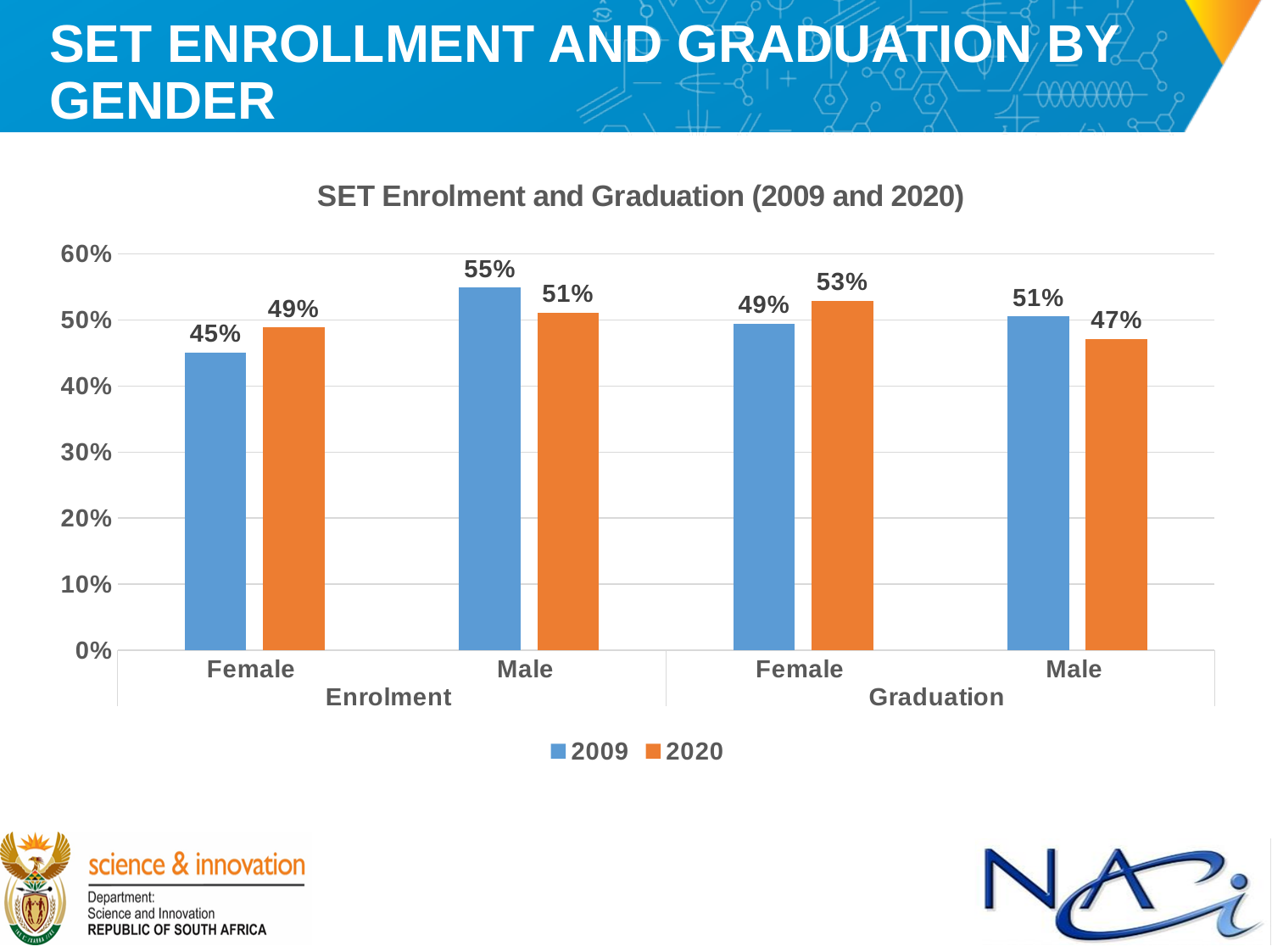
What is the difference between the 2009 and 2020 values for Female Enrolment? 4% What is the 2020 value for Female Graduation? 53% What is the title of the chart? SET Enrolment and Graduation (2009 and 2020) Which category has the highest 2009 value? Male Enrolment What kind of chart is shown on the slide? Bar chart What is the difference between the 2009 and 2020 values for Male Enrolment? 4% Which is larger for Male Graduation, the 2009 value or the 2020 value? 2009 What is the 2009 value for Female Enrolment? 45% How many series does the legend list? 2 What is the 2020 value for Male Graduation? 47% Which category has the lowest 2009 value? Female Enrolment Which colour represents the 2020 series? Orange